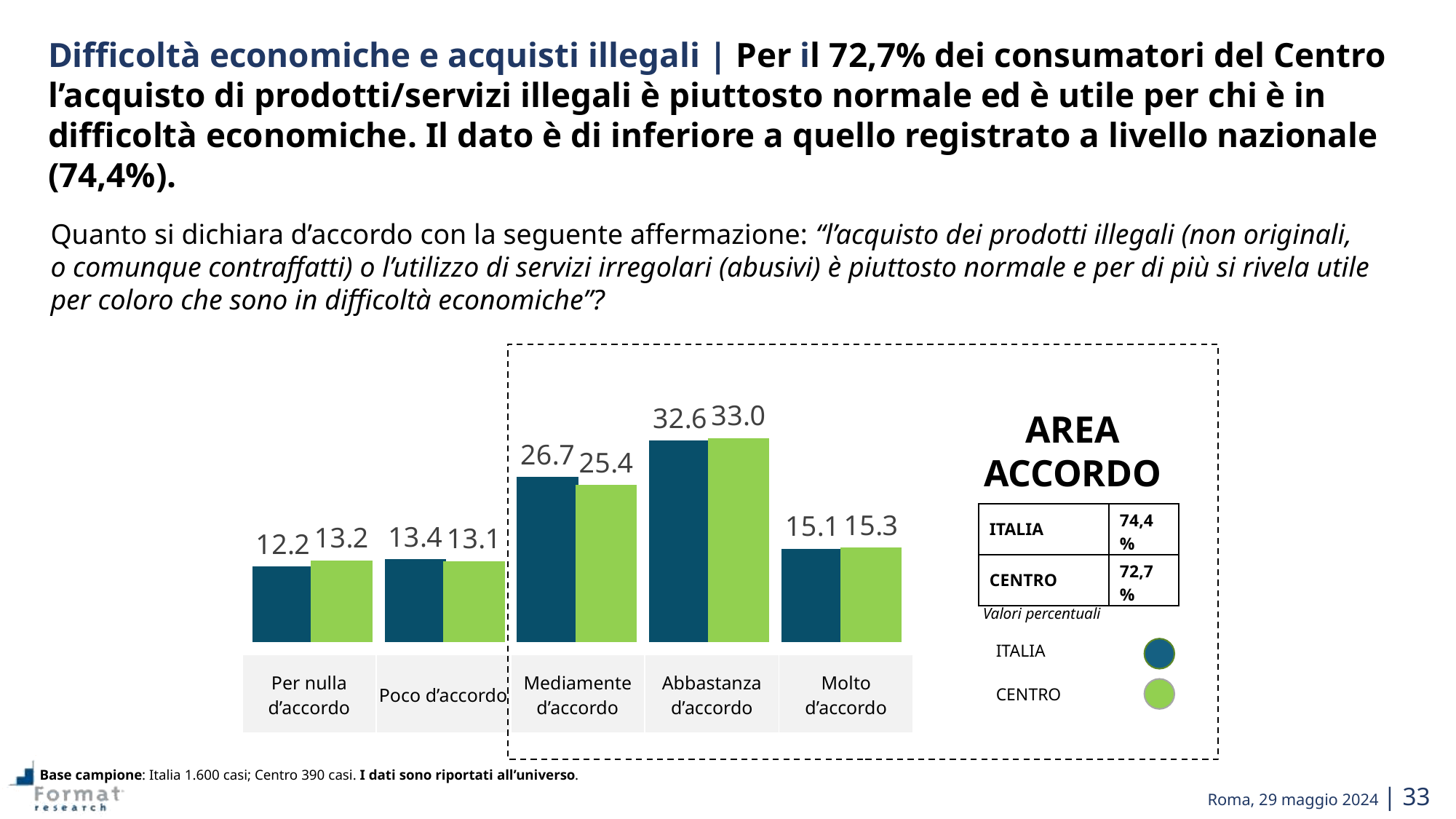
What is the ITALIA value for "Molto d'accordo"? 15.1 What is the CENTRO value for "Per nulla d'accordo"? 13.2 Which category has the lowest ITALIA value? Per nulla d'accordo What is the ITALIA value for "Abbastanza d'accordo"? 32.6 For "Per nulla d'accordo", which is larger: the ITALIA value or the CENTRO value? CENTRO What is the difference between the ITALIA and CENTRO values for "Mediamente d'accordo"? 1.3 Which category has the highest CENTRO value? Abbastanza d'accordo What kind of chart is shown on the slide? Bar chart What is the CENTRO value for "Mediamente d'accordo"? 25.4 How many categories are shown on the x axis of the chart? 5 How many series does the legend list? 2 What is the AREA ACCORDO value for CENTRO shown in the table? 72,7%